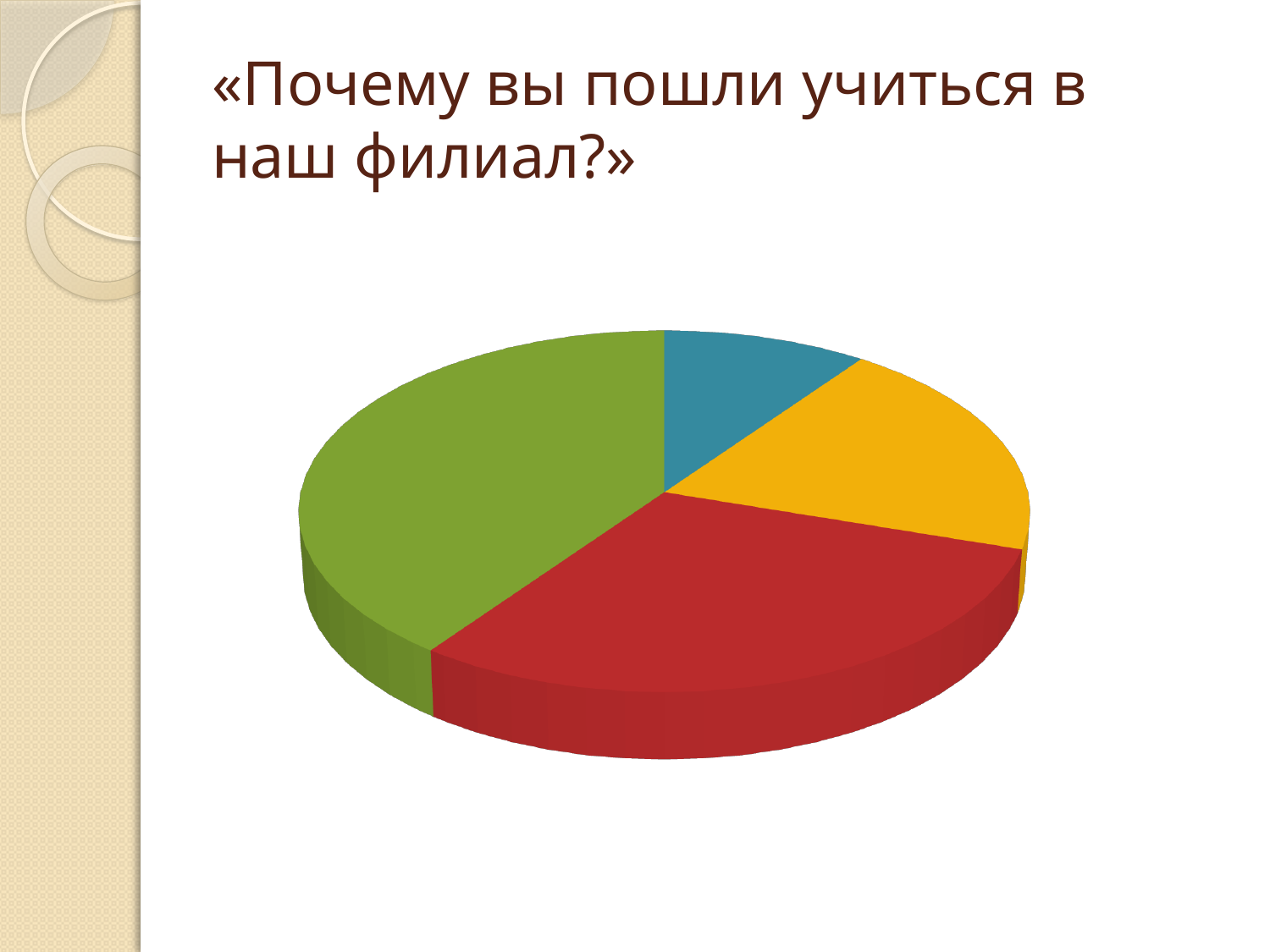
Which is larger in the pie chart, the blue slice or the yellow slice? yellow Which is larger in the pie chart, the red slice or the blue slice? red Which colour slice is the smallest in the pie chart? blue Which is larger in the pie chart, the green slice or the yellow slice? green What is the title of the slide containing the pie chart? «Почему вы пошли учиться в наш филиал?» Does the pie chart include a legend? No How many slices does the pie chart have? 4 What kind of chart is shown on the slide? pie chart